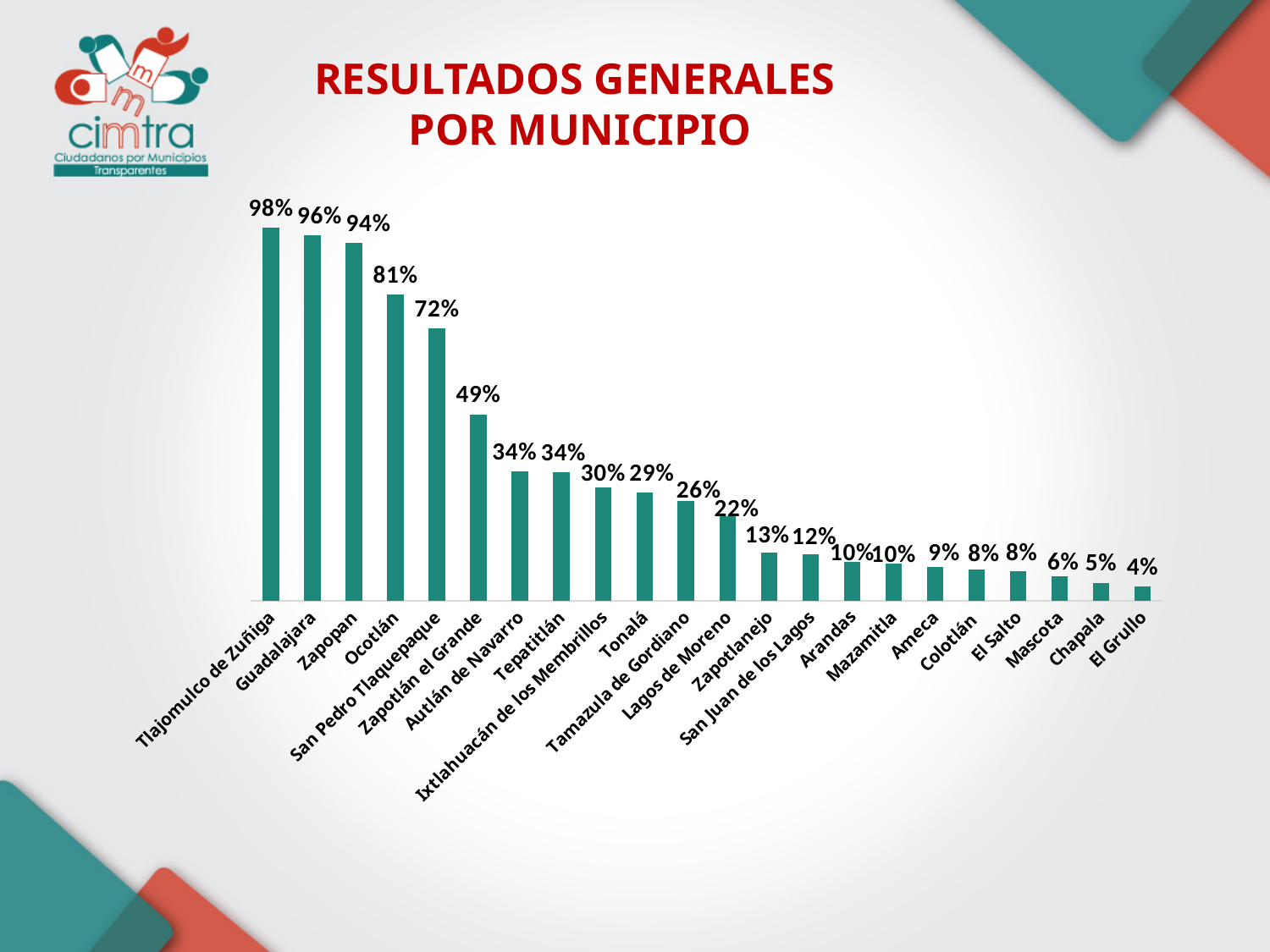
What is the value for Mascota? 6% What kind of chart is shown on the slide? Bar chart Which municipality has the lowest value? El Grullo What is the difference between the values for Ocotlán and San Pedro Tlaquepaque? 9% What is the value for Guadalajara? 96% Which is larger, the value for Tamazula de Gordiano or the value for Zapotlanejo? Tamazula de Gordiano Do the values rise or fall from left to right along the x axis? Fall What is the difference between the values for Zapopan and Tonalá? 65% How many municipalities are shown in the chart? 22 What is the value for Zapotlán el Grande? 49% Which municipality has the highest value? Tlajomulco de Zuñiga What is the value for Lagos de Moreno? 22%